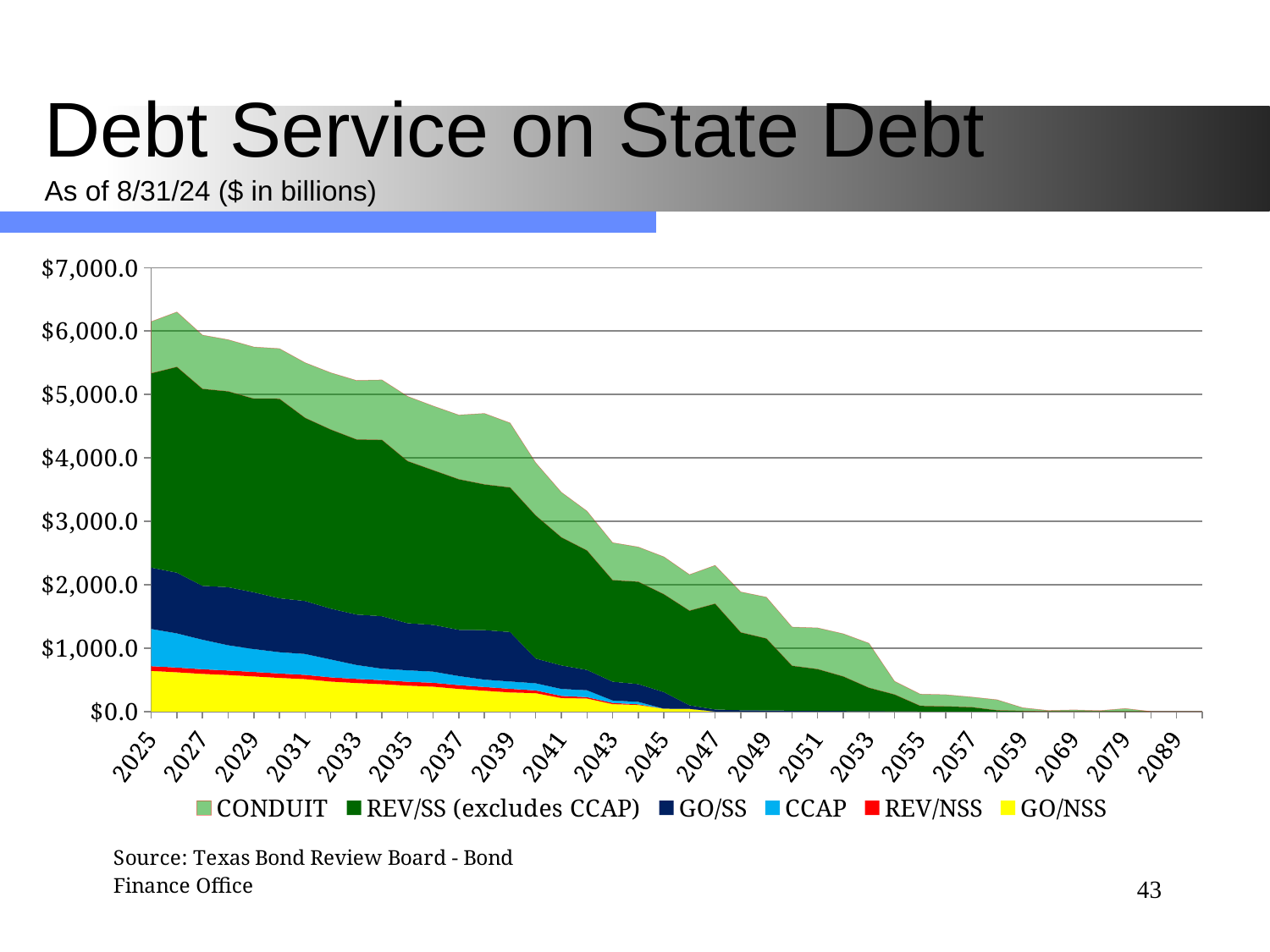
What colour represents GO/NSS in the chart? Yellow Is the total debt service for 2045 greater or less than $3,000.0? less What kind of chart is shown on the slide? Stacked area chart How many year labels are shown on the x axis? 21 In 2025, which is larger: GO/NSS or REV/NSS? GO/NSS Is the total debt service for 2035 greater or less than $3,000.0? greater What is the title of the chart slide? Debt Service on State Debt Is the total debt service for 2025 greater or less than $5,000.0? greater Which series contributes the largest amount of debt service in 2025? REV/SS (excludes CCAP) How many series does the legend list? 6 Do the total debt service values rise or fall as the years move from 2025 toward 2089? Fall